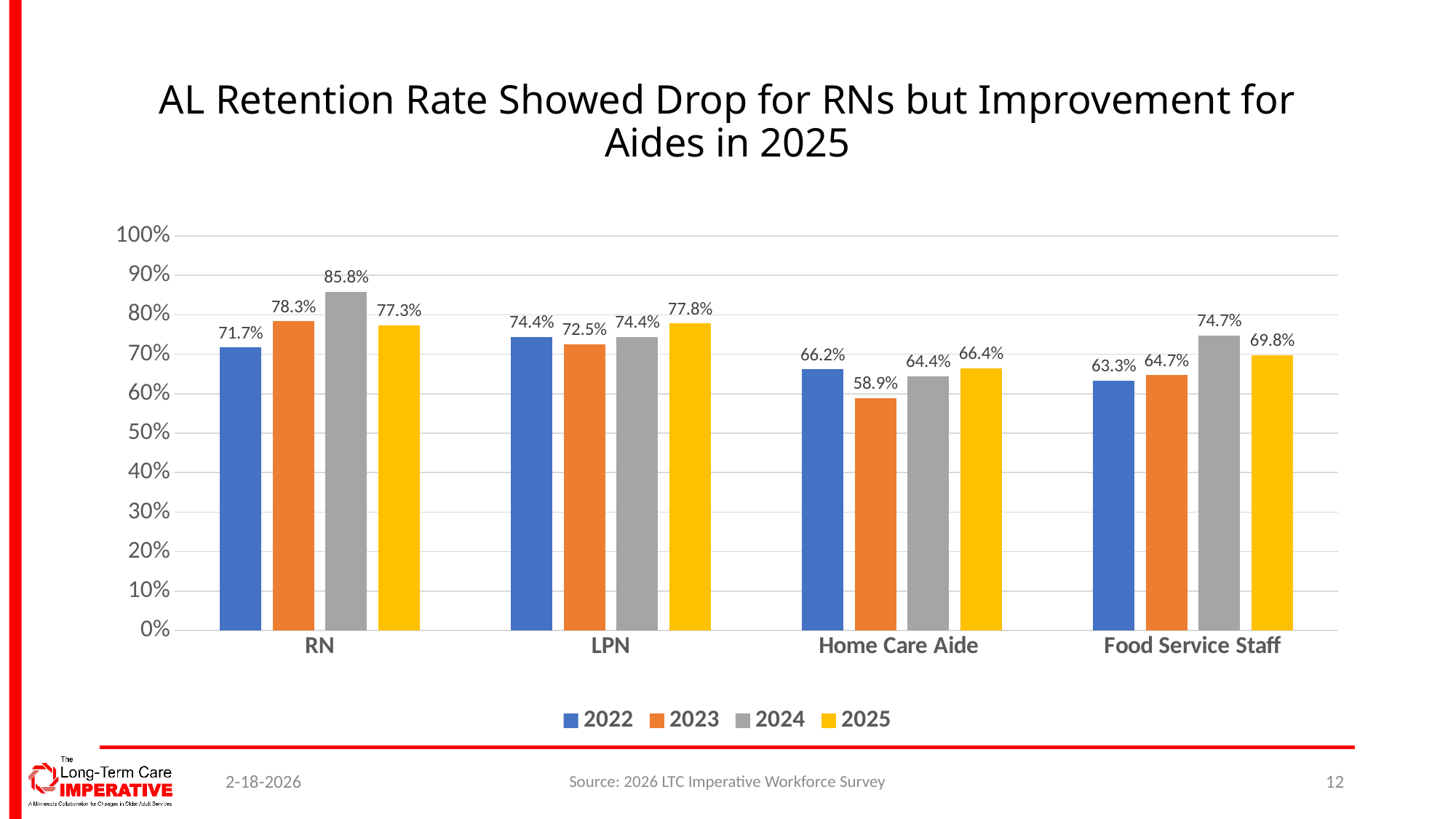
Which category has the lowest 2023 retention rate? Home Care Aide Which colour represents 2025 in the legend? yellow What is the 2023 retention rate for Home Care Aide? 58.9% What kind of chart is shown on the slide? bar chart What is the 2024 retention rate for RN? 85.8% Is the 2023 retention rate for Home Care Aide greater or less than 60%? less How many series does the legend list? 4 What is the 2025 retention rate for Food Service Staff? 69.8% What is the difference between the 2024 and 2025 retention rates for RN? 8.5% Is the 2025 retention rate for LPN higher or lower than the 2025 rate for Home Care Aide? higher Which category has the highest 2024 retention rate? RN How many job categories are shown on the x axis? 4